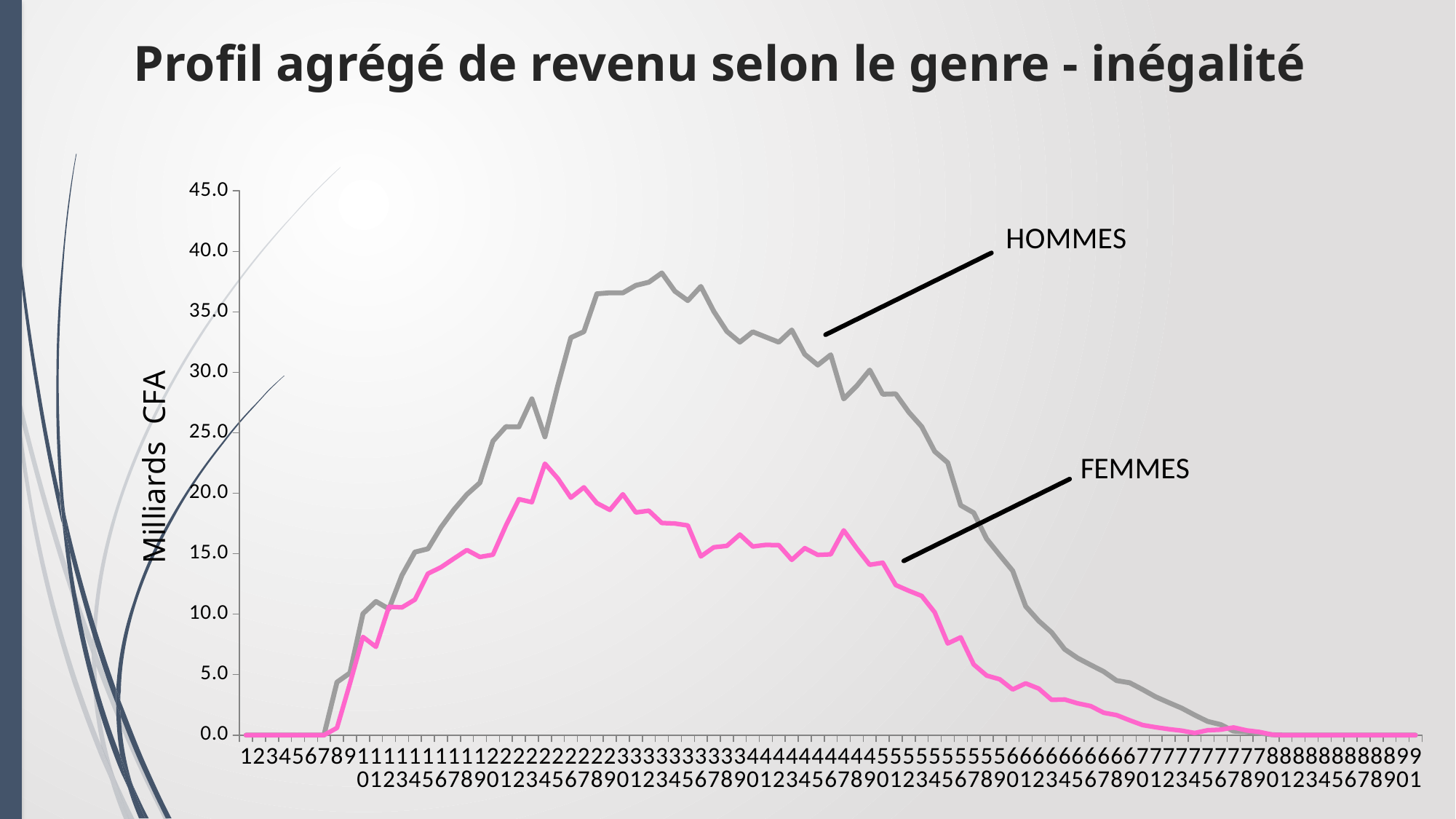
After reaching their peaks, do the HOMMES and FEMMES values rise or fall toward the right end of the x axis? fall Which series reaches the higher peak value, HOMMES or FEMMES? HOMMES Is the peak value of the FEMMES series greater or less than 20.0? greater What is the highest tick value shown on the vertical axis? 45.0 Which series is drawn in pink? FEMMES What kind of chart is shown on the slide? line chart Is the peak value of the FEMMES series greater or less than 25.0? less What is the label of the vertical axis? Milliards CFA Is the peak value of the HOMMES series greater or less than 40.0? less How many series are plotted on the chart? 2